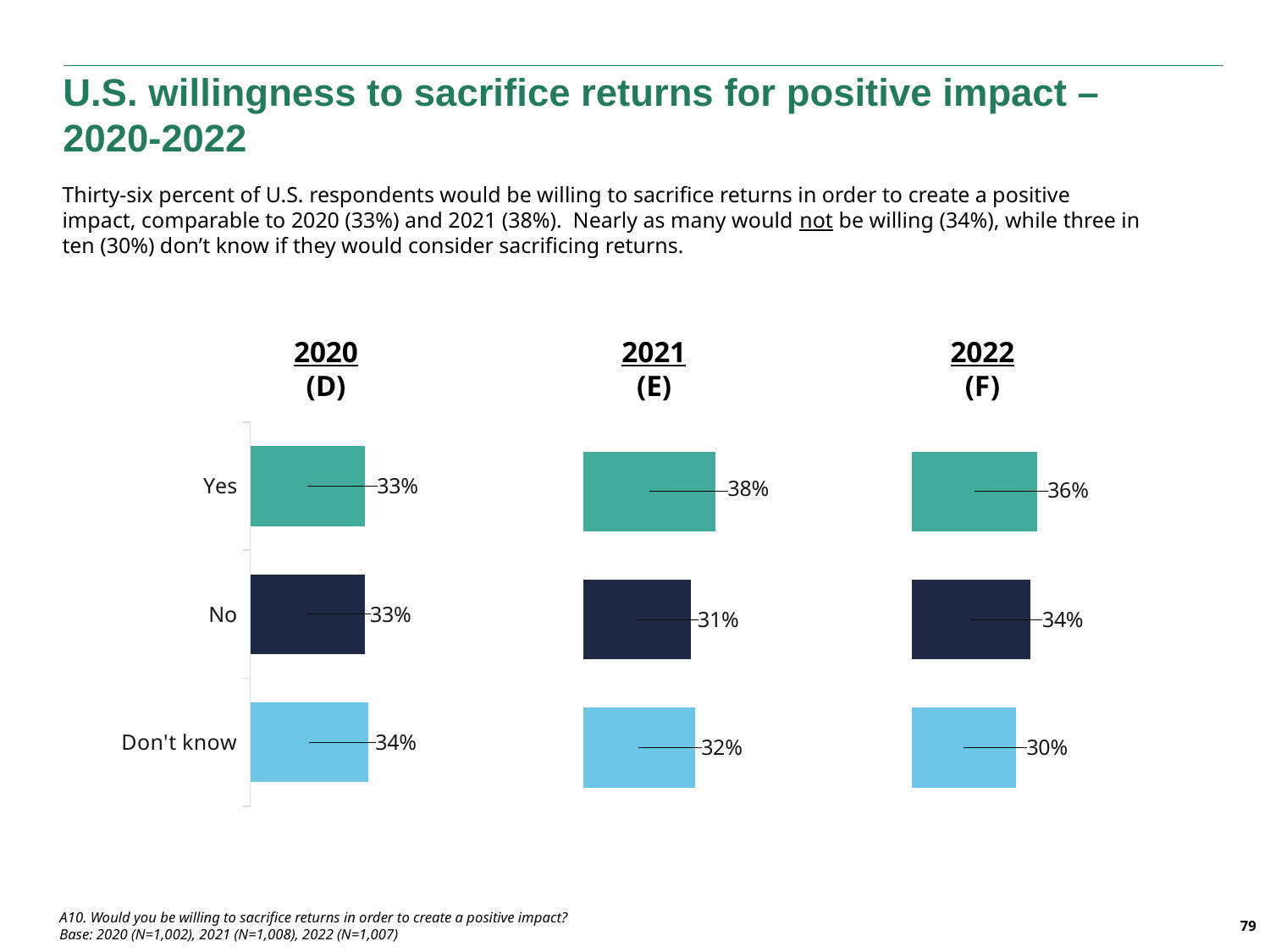
In the 2020 (D) chart, what is the value for Yes? 33% In the 2022 (F) chart, what is the difference between the Yes value and the Don't know value? 6% In the 2022 (F) chart, which category has the lowest value? Don't know In the 2022 (F) chart, what is the value for Yes? 36% In the 2022 (F) chart, what is the value for Don't know? 30% What type of chart is used for the 2020 (D) data? Bar chart In the 2020 (D) chart, which category has the highest value? Don't know Which is larger: the Yes value in the 2021 (E) chart or the Yes value in the 2022 (F) chart? 2021 (E) In the 2021 (E) chart, what is the difference between the Yes value and the No value? 7% In the 2021 (E) chart, what is the value for No? 31% How many categories does each chart show? 3 In the 2021 (E) chart, which category has the highest value? Yes